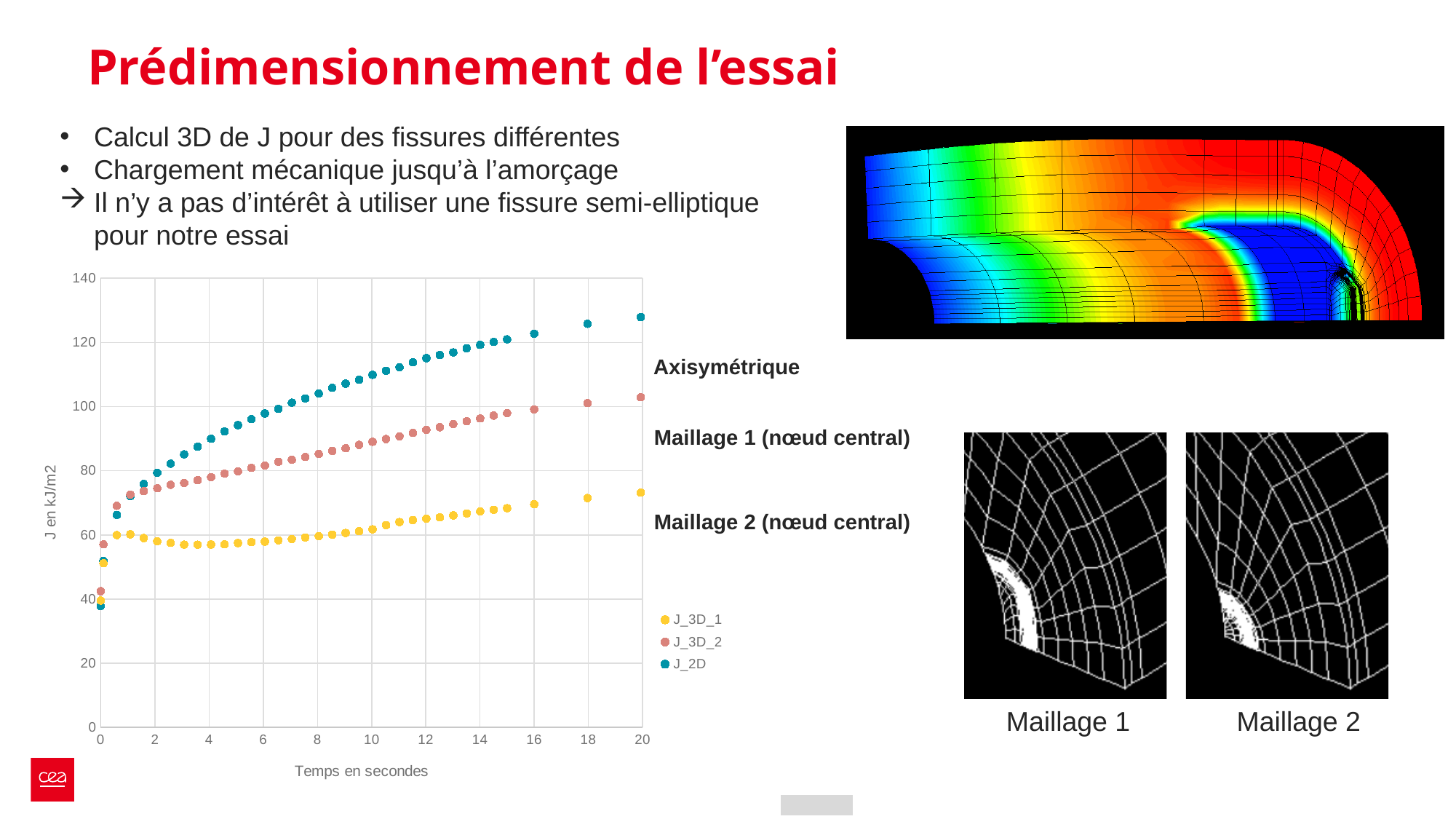
At 20 seconds, which series has the larger value, J_2D or J_3D_1? J_2D What are the series names listed in the chart legend? J_3D_1, J_3D_2, J_2D Is the value of J_3D_1 at 20 seconds greater or less than 80? less Is the value of J_3D_2 at 10 seconds greater or less than 100? less How many series does the chart legend list? 3 Is the value of J_2D at 20 seconds greater or less than 120? greater Which series has the highest value at 20 seconds? J_2D Which series has the lowest value at 20 seconds? J_3D_1 Does the J_2D series rise or fall as time increases from 0 to 20 seconds? rises What is the title of the vertical axis of the chart? J en kJ/m2 What kind of chart is shown on the slide? scatter chart